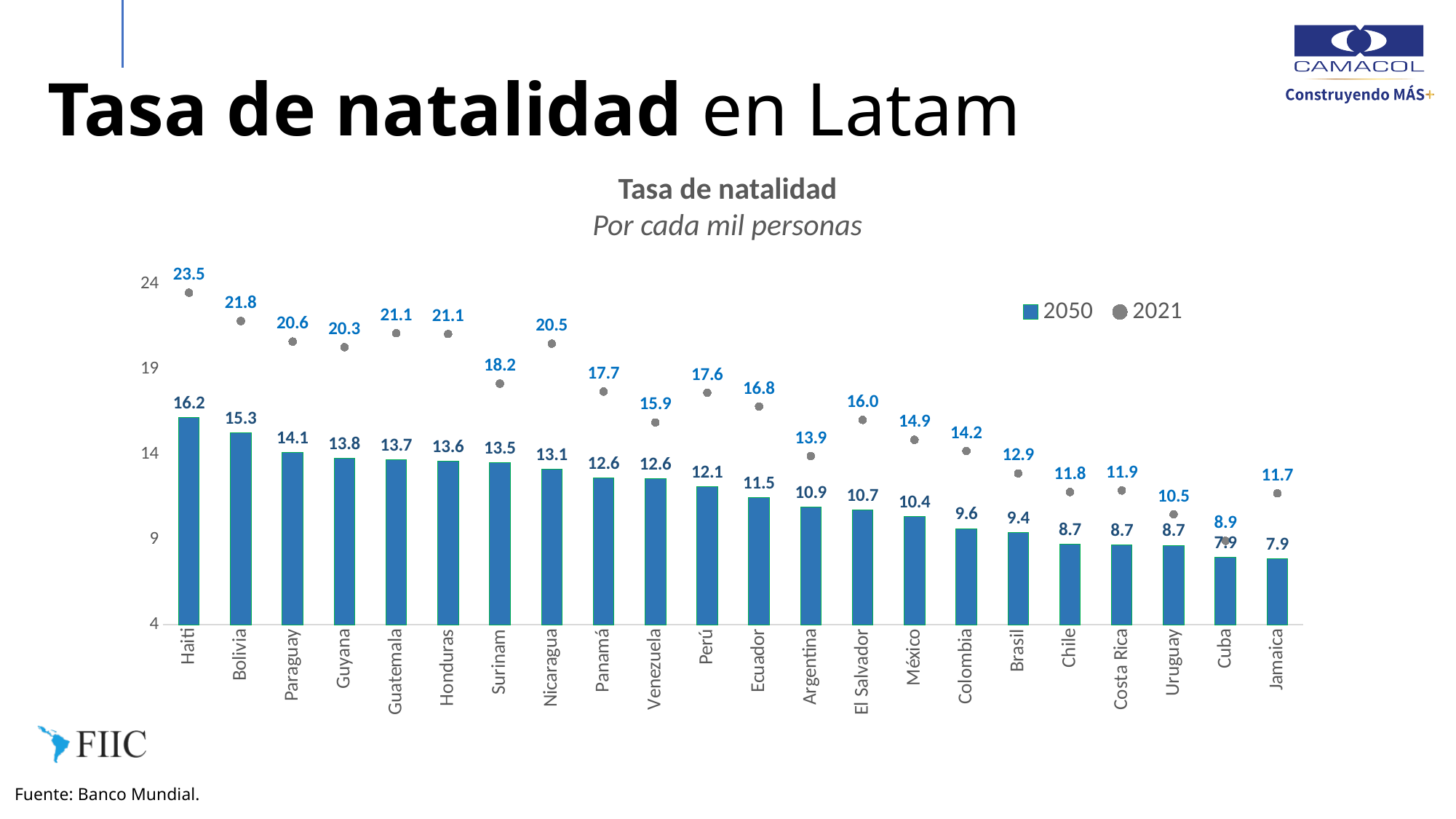
What is the 2050 value for Colombia? 9.6 What kind of chart is used for the 2050 series? bar chart How many series does the legend list? 2 What is the difference between the 2021 and 2050 values for Bolivia? 6.5 Which country has the lowest 2021 value? Cuba How many countries are shown on the x axis? 22 What is the 2021 value for Haiti? 23.5 Which is larger, the 2050 value for Perú or the 2050 value for Ecuador? Perú What is the 2021 value for Argentina? 13.9 Which country has the highest 2050 value? Haiti What is the subtitle of the chart? Por cada mil personas Is the 2021 value for Surinam greater or less than 19? less